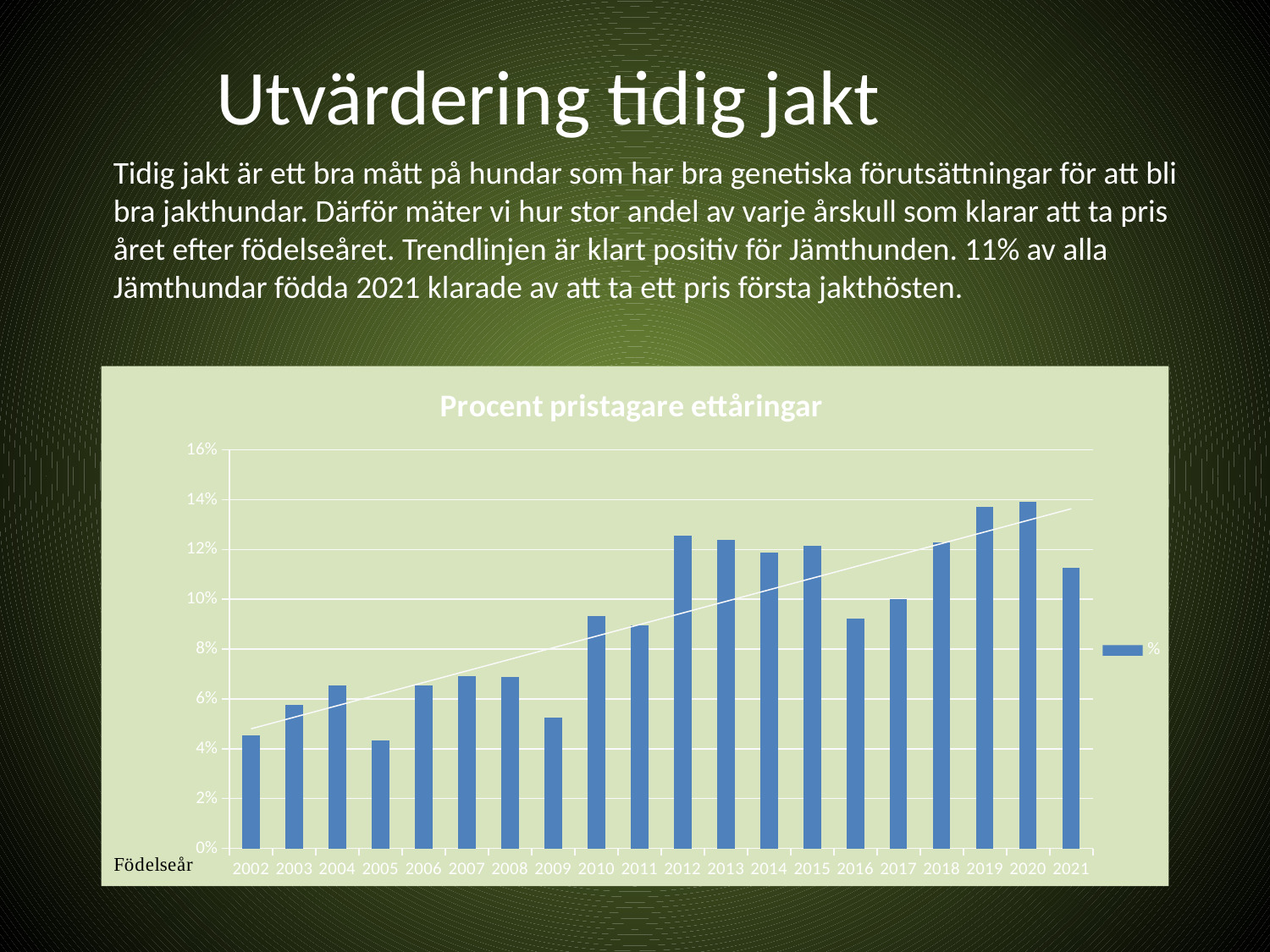
Which year has the larger value, 2002 or 2012? 2012 Which year has the larger value, 2009 or 2010? 2010 How many birth years (categories) are shown on the x axis of the chart? 20 What is the label on the x axis of the chart? Födelseår How many series does the chart legend list? 1 Is the value for 2012 greater or less than 12%? greater Do the values generally rise or fall from 2002 to 2021? rise Is the value for 2016 greater or less than 10%? less Is the value for 2021 greater or less than 10%? greater What kind of chart is shown on the slide? bar chart What is the title of the chart? Procent pristagare ettåringar